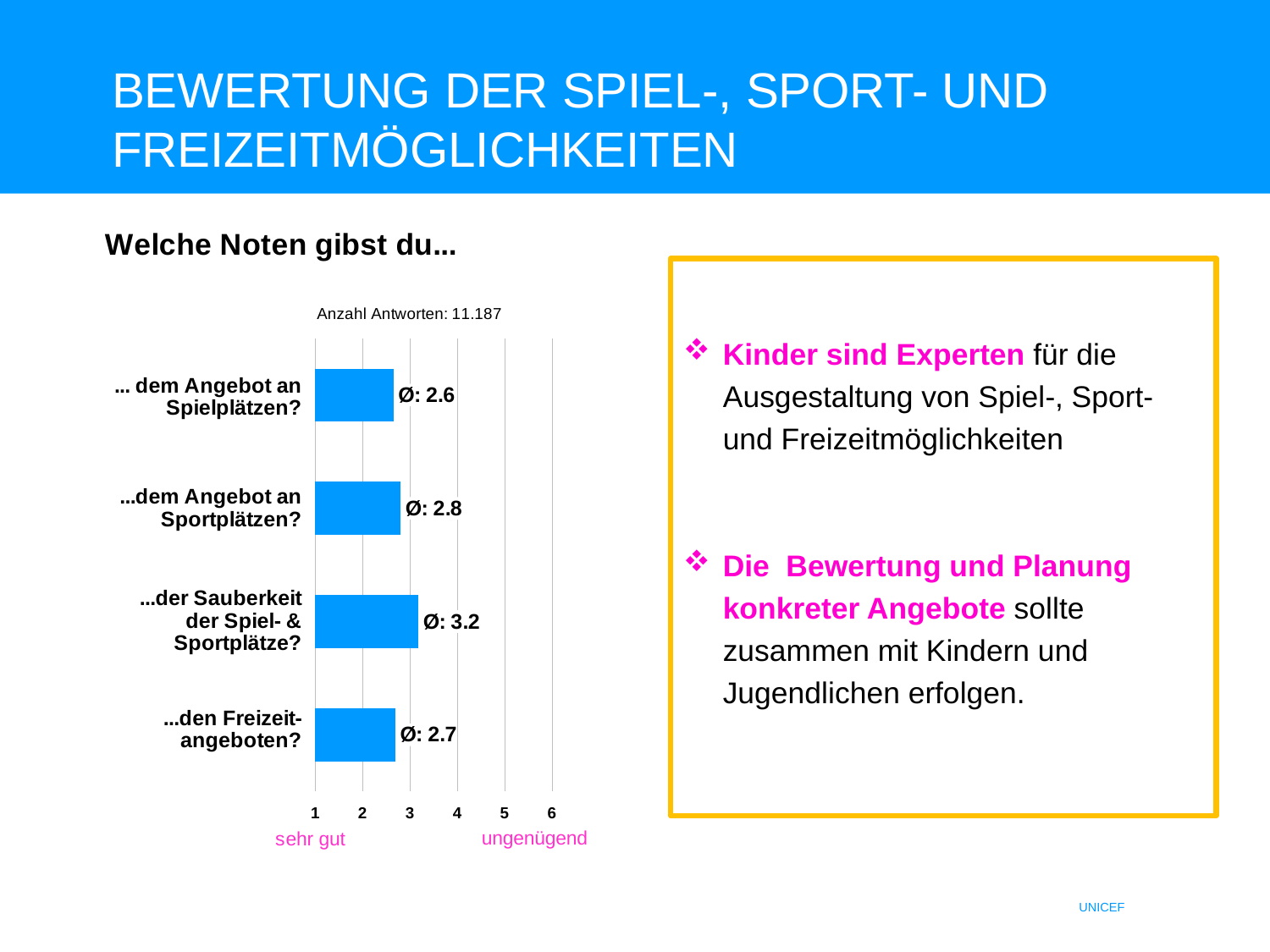
What is the difference between the average grade for "...der Sauberkeit der Spiel- & Sportplätze?" and "... dem Angebot an Spielplätzen?"? 0.6 What is the average grade (Ø) given for "...der Sauberkeit der Spiel- & Sportplätze?"? Ø: 3.2 What kind of chart is shown on the slide? bar chart Which category has the highest average grade value? ...der Sauberkeit der Spiel- & Sportplätze? Which category has the lowest average grade value? ... dem Angebot an Spielplätzen? Which has the larger average grade value: "...dem Angebot an Sportplätzen?" or "...den Freizeitangeboten?"? ...dem Angebot an Sportplätzen? How many categories are shown in the chart? 4 How many responses (Anzahl Antworten) does the chart state? 11.187 What is the average grade (Ø) given for "...den Freizeitangeboten?"? Ø: 2.7 What is the average grade (Ø) given for "... dem Angebot an Spielplätzen?"? Ø: 2.6 Is the value for "...der Sauberkeit der Spiel- & Sportplätze?" greater or less than 3? greater What is the average grade (Ø) given for "...dem Angebot an Sportplätzen?"? Ø: 2.8